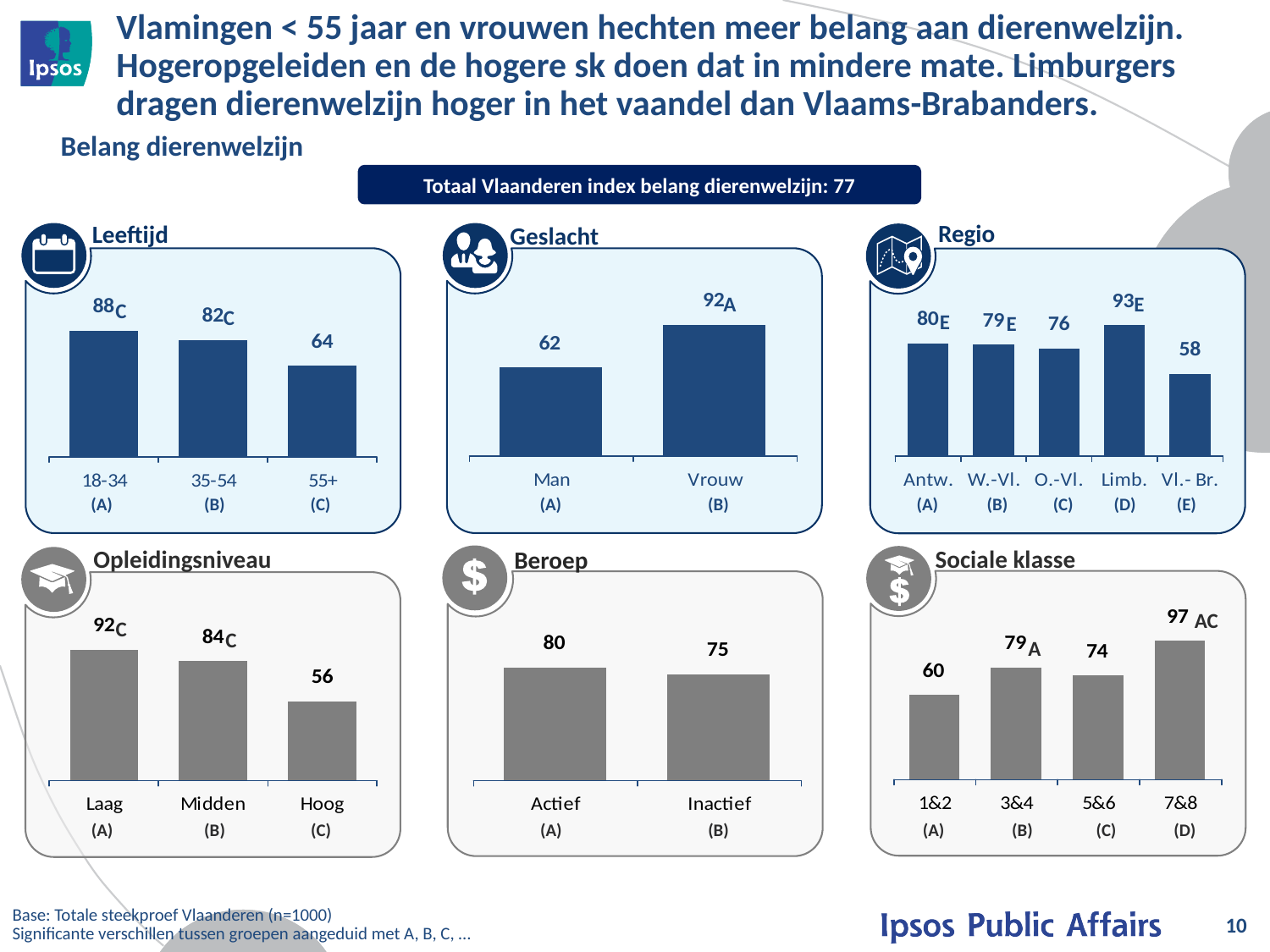
In the Sociale klasse chart, what is the difference between the values for 7&8 and 1&2? 37 What kind of chart is the Leeftijd chart? bar chart In the Regio chart, which region has the lowest value? Vl.- Br. In the Beroep chart, which is larger, the value for Actief or Inactief? Actief In the Geslacht chart, what is the difference between the values for Vrouw and Man? 30 In the Sociale klasse chart, what is the value for the 7&8 group? 97 In the Regio chart, which region has the highest value? Limb. How many categories are shown in the Regio chart? 5 In the Leeftijd chart, what is the value for the 18-34 group? 88 In the Leeftijd chart, do the values rise or fall from the 18-34 group to the 55+ group? fall What is the total Vlaanderen index for belang dierenwelzijn shown on the slide? 77 In the Opleidingsniveau chart, what is the value for Hoog? 56